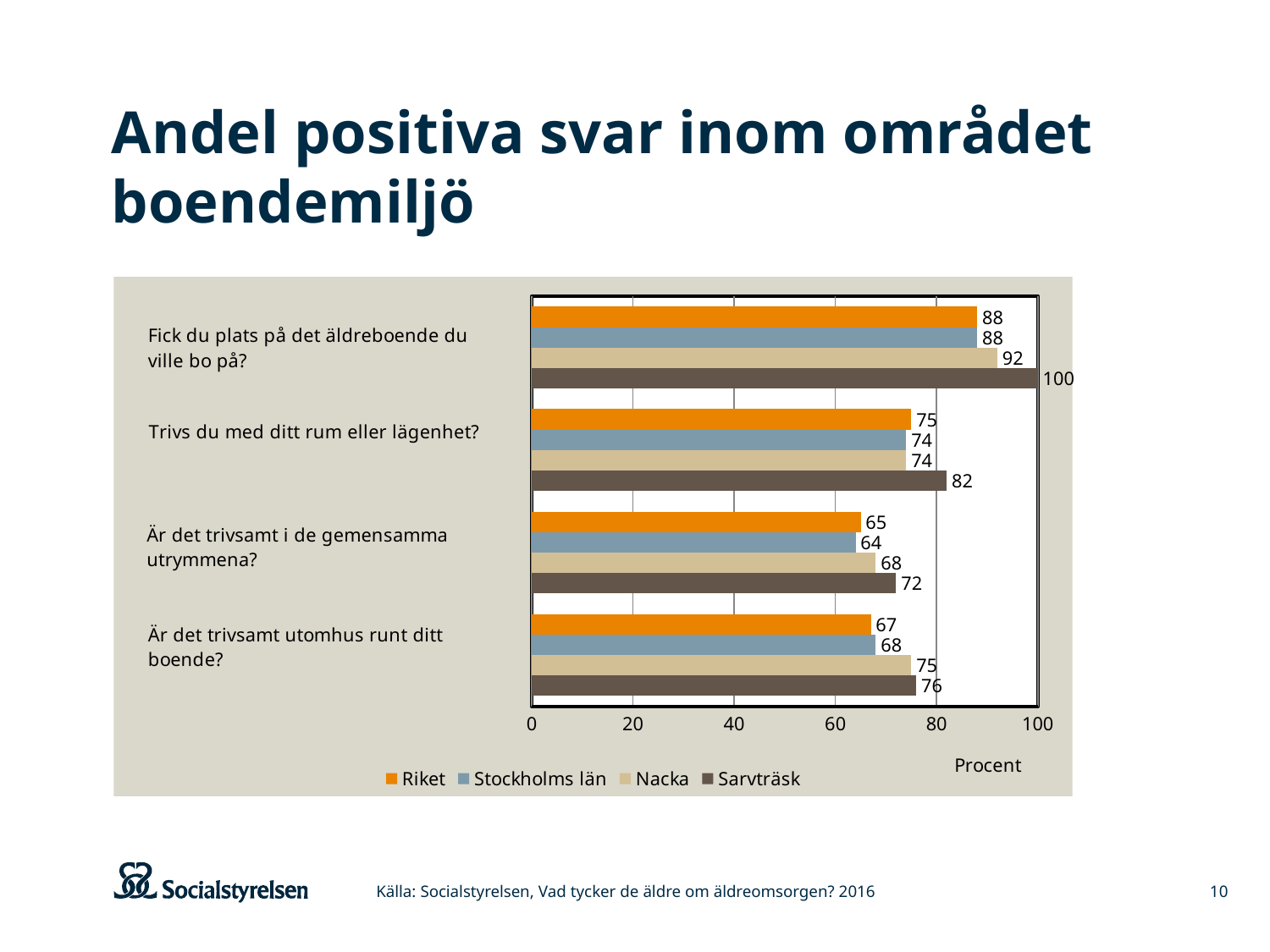
What is the difference between Sarvträsk and Riket on "Fick du plats på det äldreboende du ville bo på?"? 12 What is the value for Riket on "Är det trivsamt utomhus runt ditt boende?"? 67 How many series does the legend list? 4 Which series has the highest value on "Trivs du med ditt rum eller lägenhet?"? Sarvträsk What is the value for Sarvträsk on "Fick du plats på det äldreboende du ville bo på?"? 100 What is the value for Nacka on "Trivs du med ditt rum eller lägenhet?"? 74 How many questions (categories) are shown on the chart? 4 What is the value for Stockholms län on "Är det trivsamt i de gemensamma utrymmena?"? 64 What is the label of the horizontal axis? Procent What kind of chart is shown on the slide? Bar chart Which series has the lowest value on "Är det trivsamt i de gemensamma utrymmena?"? Stockholms län Which is larger on "Är det trivsamt utomhus runt ditt boende?": Nacka or Stockholms län? Nacka